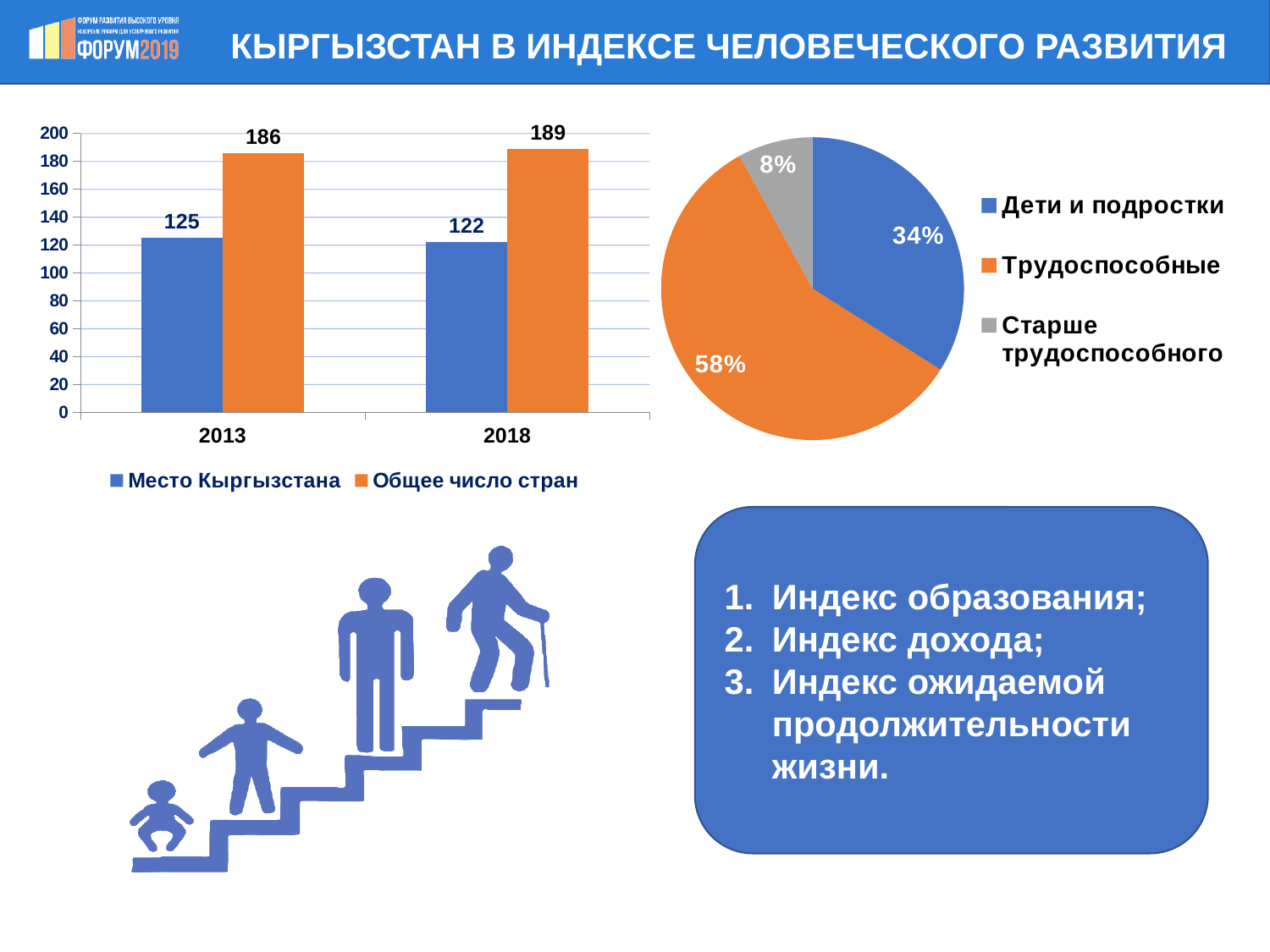
What kind of chart is the chart on the left of the slide? bar chart In the bar chart on the left, does Место Кыргызстана rise or fall from 2013 to 2018? fall How many slices does the pie chart on the right have? 3 In the bar chart on the left, what is the difference between Общее число стран and Место Кыргызстана in 2013? 61 In the bar chart on the left, what is the value of Общее число стран for 2018? 189 In the bar chart on the left, what is the value of Место Кыргызстана for 2018? 122 In the bar chart on the left, what is the value of Место Кыргызстана for 2013? 125 In the bar chart on the left, which is larger in 2018: Место Кыргызстана or Общее число стран? Общее число стран How many series does the legend of the bar chart on the left list? 2 In the bar chart on the left, by how much did Общее число стран change from 2013 to 2018? 3 In the pie chart on the right, what share is Трудоспособные? 58% In the pie chart on the right, which category has the smallest share? Старше трудоспособного